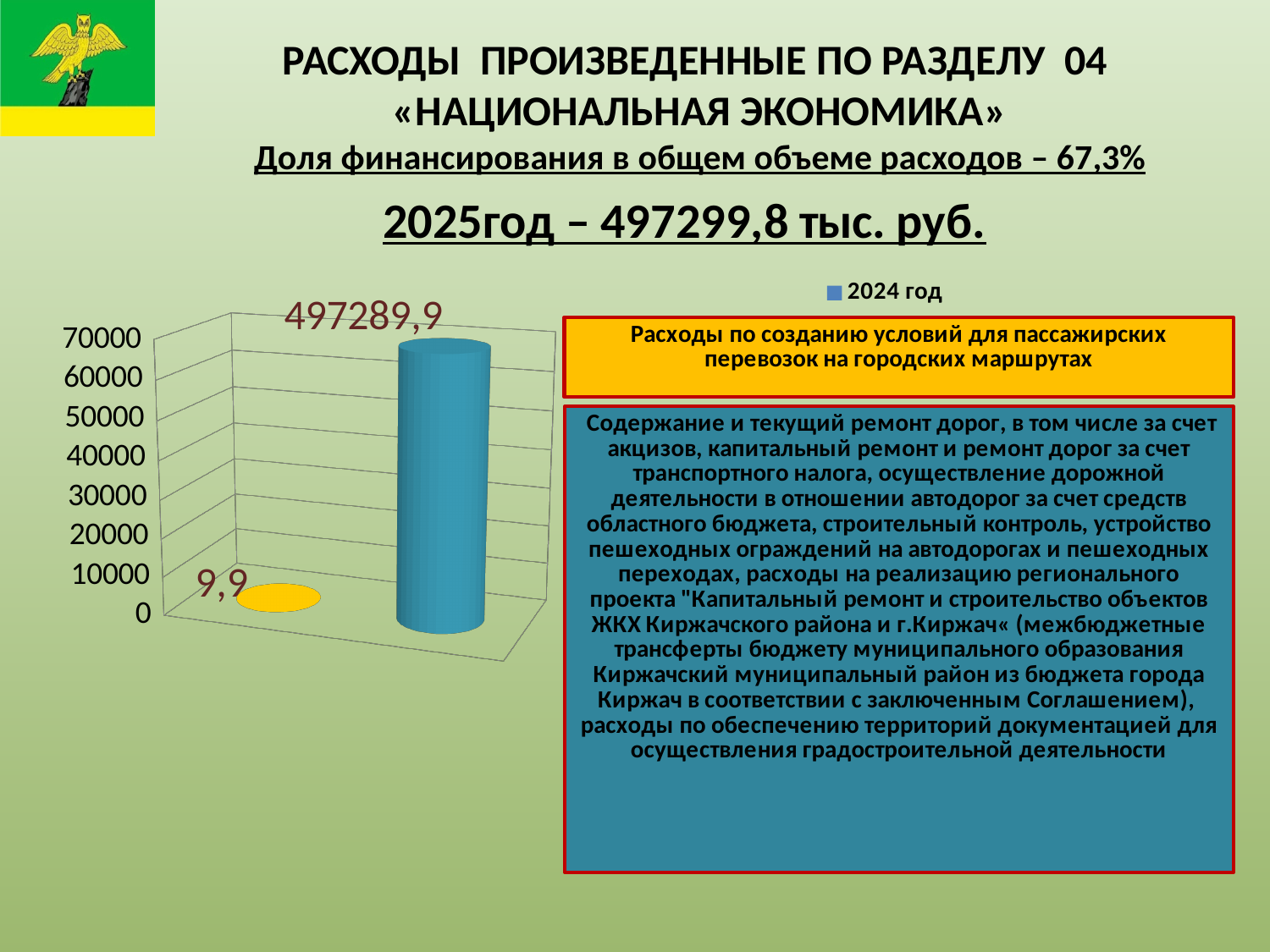
What kind of chart is shown on the slide? bar chart Which bar in the chart has the lowest value, the yellow one or the blue one? the yellow one What is the sum of the two values printed on the bars in the chart? 497299,8 What value is printed on the blue bar in the chart? 497289,9 How many bars are plotted in the chart? 2 What value is printed on the yellow bar in the chart? 9,9 How many series does the chart legend list? 1 Which bar in the chart has the highest value, the yellow one or the blue one? the blue one What is the legend entry shown above the chart? 2024 год What is the difference between the value of the blue bar and the value of the yellow bar? 497280,0 Is the value of the blue bar larger or smaller than the value of the yellow bar? larger Is the value of the yellow bar greater or less than 10000? less